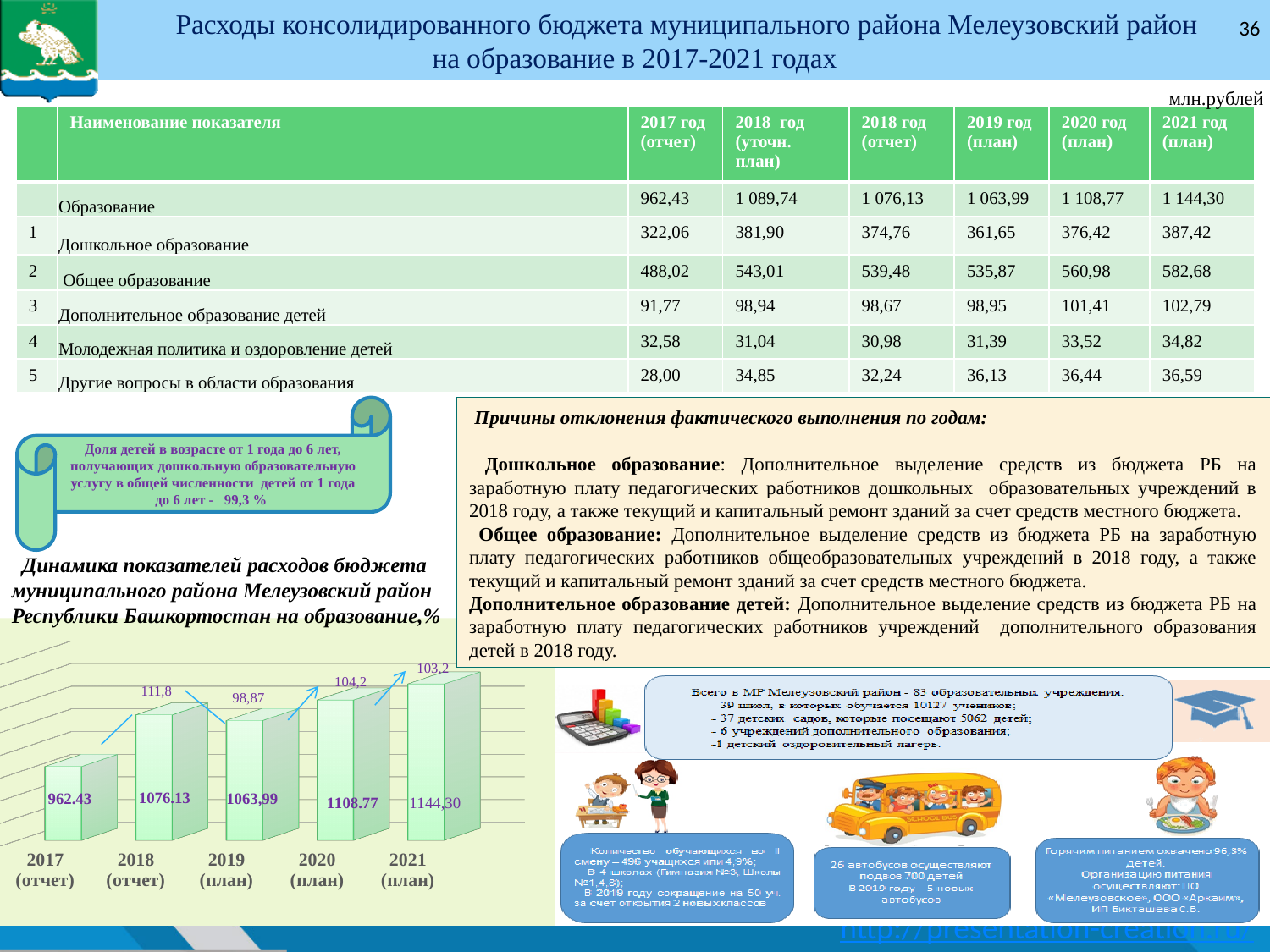
In the bar chart at the bottom left, what is the value for 2019 (план)? 1063,99 In the bar chart at the bottom left, how many bars (years) are shown? 5 In the bar chart at the bottom left, what is the value for 2017 (отчет)? 962.43 In the bar chart at the bottom left, what percentage label is shown above the 2018 bar? 111,8 In the bar chart at the bottom left, what percentage label is shown above the 2019 bar? 98,87 In the bar chart at the bottom left, which year has the highest value? 2021 (план) In the bar chart at the bottom left, which year has the lowest value? 2017 (отчет) In the bar chart at the bottom left, what is the difference between the values for 2018 (отчет) and 2017 (отчет)? 113.70 In the bar chart at the bottom left, which is larger: the value for 2018 (отчет) or 2019 (план)? 2018 (отчет) In the bar chart at the bottom left, what is the value for 2018 (отчет)? 1076.13 What type of chart is shown at the bottom left of the slide? bar chart In the bar chart at the bottom left, what is the value for 2021 (план)? 1144,30